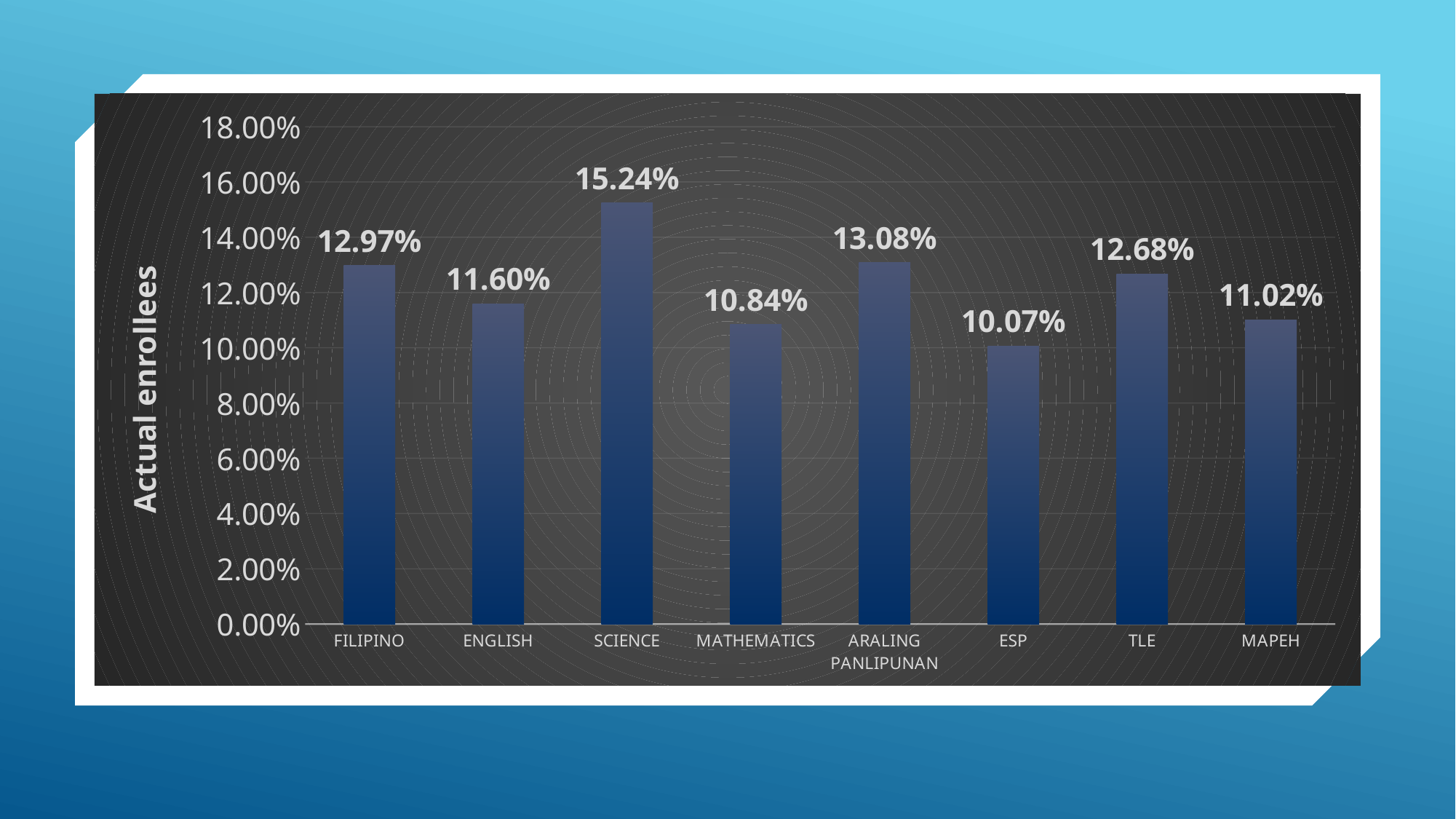
What is the value for ESP? 10.07% How many categories are shown on the x axis? 8 What kind of chart is this? bar chart What is the value for ARALING PANLIPUNAN? 13.08% Which is larger, the value for TLE or the value for MATHEMATICS? TLE What is the value for SCIENCE? 15.24% What is the value for MAPEH? 11.02% Which category has the highest value? SCIENCE What is the label on the vertical axis? Actual enrollees What is the difference between the values for FILIPINO and ENGLISH? 1.37% What is the difference between the values for SCIENCE and ESP? 5.17% Which category has the lowest value? ESP